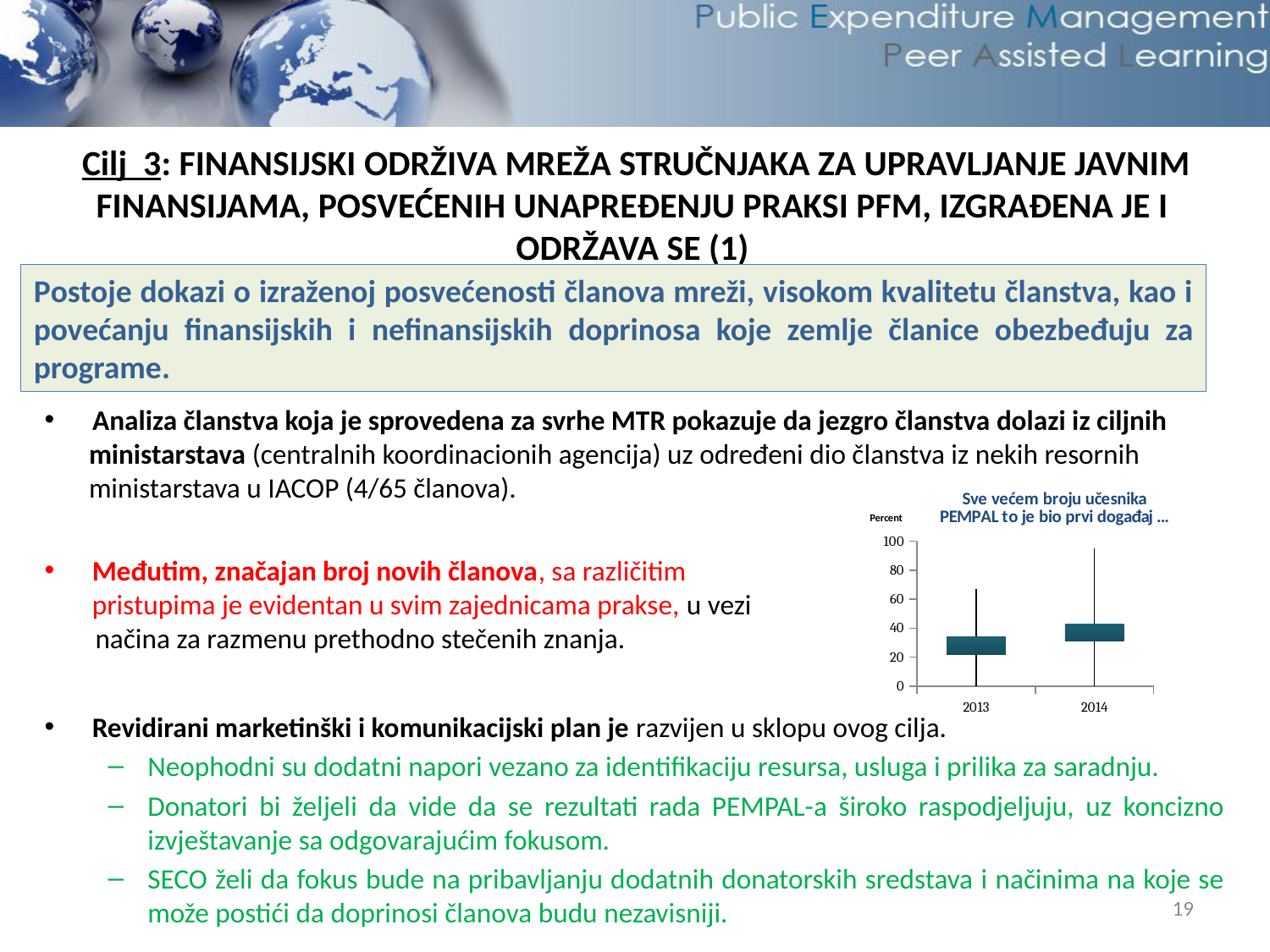
Is the bottom of the box for 2014 greater or less than 20? greater Do the values on the chart rise or fall from 2013 to 2014? rise Is the top of the upper whisker for 2013 greater or less than 80? less How many categories are shown on the x axis of the chart? 2 Which years are shown on the x axis of the chart? 2013 and 2014 What is the highest value shown on the vertical axis of the chart? 100 What kind of chart is shown on the slide? box-and-whisker (box plot) chart Which year has the higher box (interquartile range) on the chart, 2013 or 2014? 2014 Is the top of the upper whisker for 2014 greater or less than 80? greater What is the label of the vertical axis of the chart? Percent